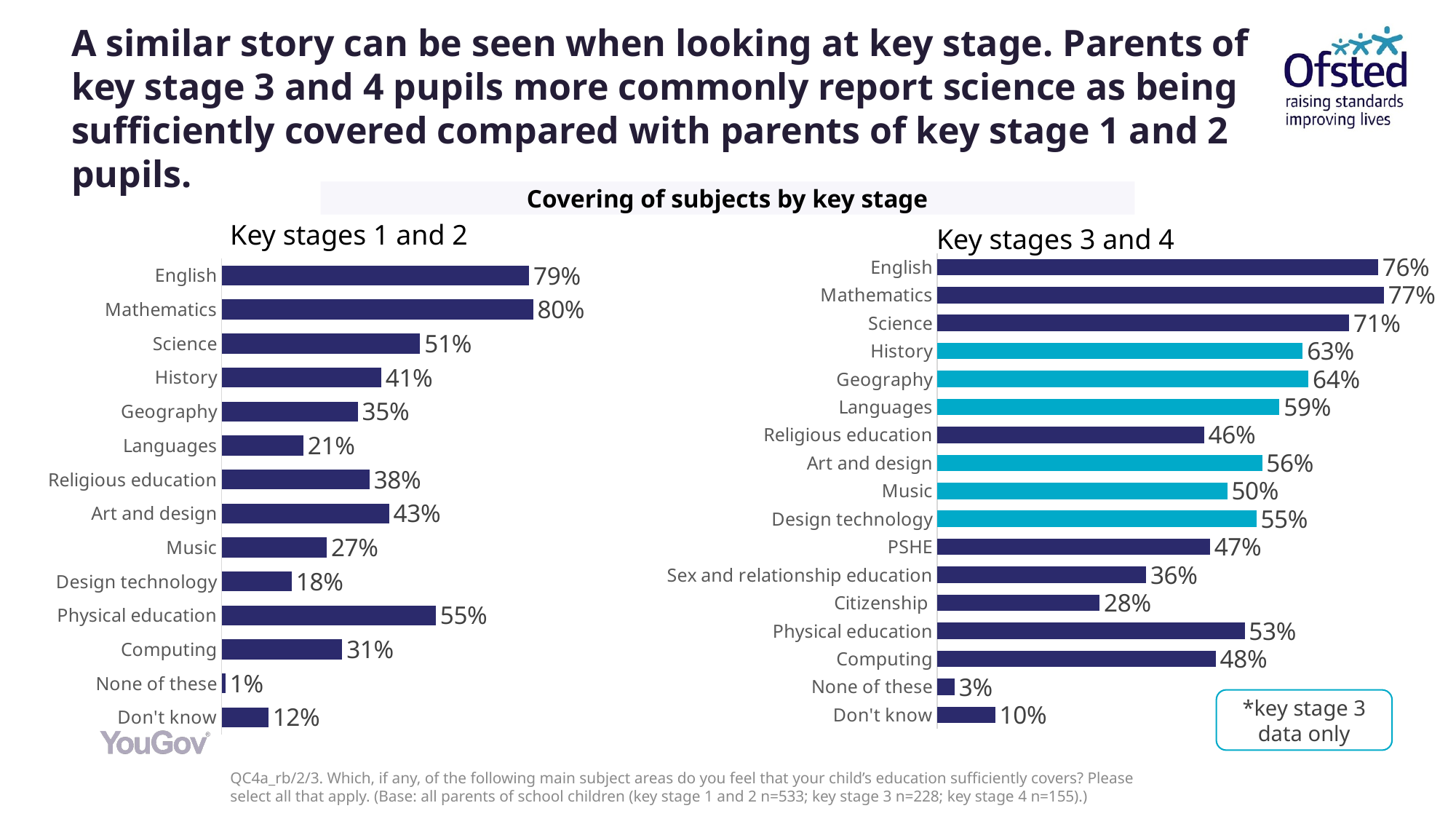
What is the overall title shown above the two charts? Covering of subjects by key stage In the Key stages 1 and 2 chart, which is larger: Physical education or Art and design? Physical education What kind of chart is used for Key stages 3 and 4? Bar chart In the Key stages 3 and 4 chart, what is the value for Science? 71% How many categories are shown in the Key stages 3 and 4 chart? 17 In the Key stages 1 and 2 chart, what is the value for Science? 51% In the Key stages 3 and 4 chart, which category has the lowest value? None of these How many categories are shown in the Key stages 1 and 2 chart? 14 In the Key stages 3 and 4 chart, what is the difference between Geography and History? 1% In the Key stages 1 and 2 chart, what is the value for Languages? 21% In the Key stages 1 and 2 chart, which subject has the highest value? Mathematics In the Key stages 3 and 4 chart, what is the difference between Mathematics and Don't know? 67%